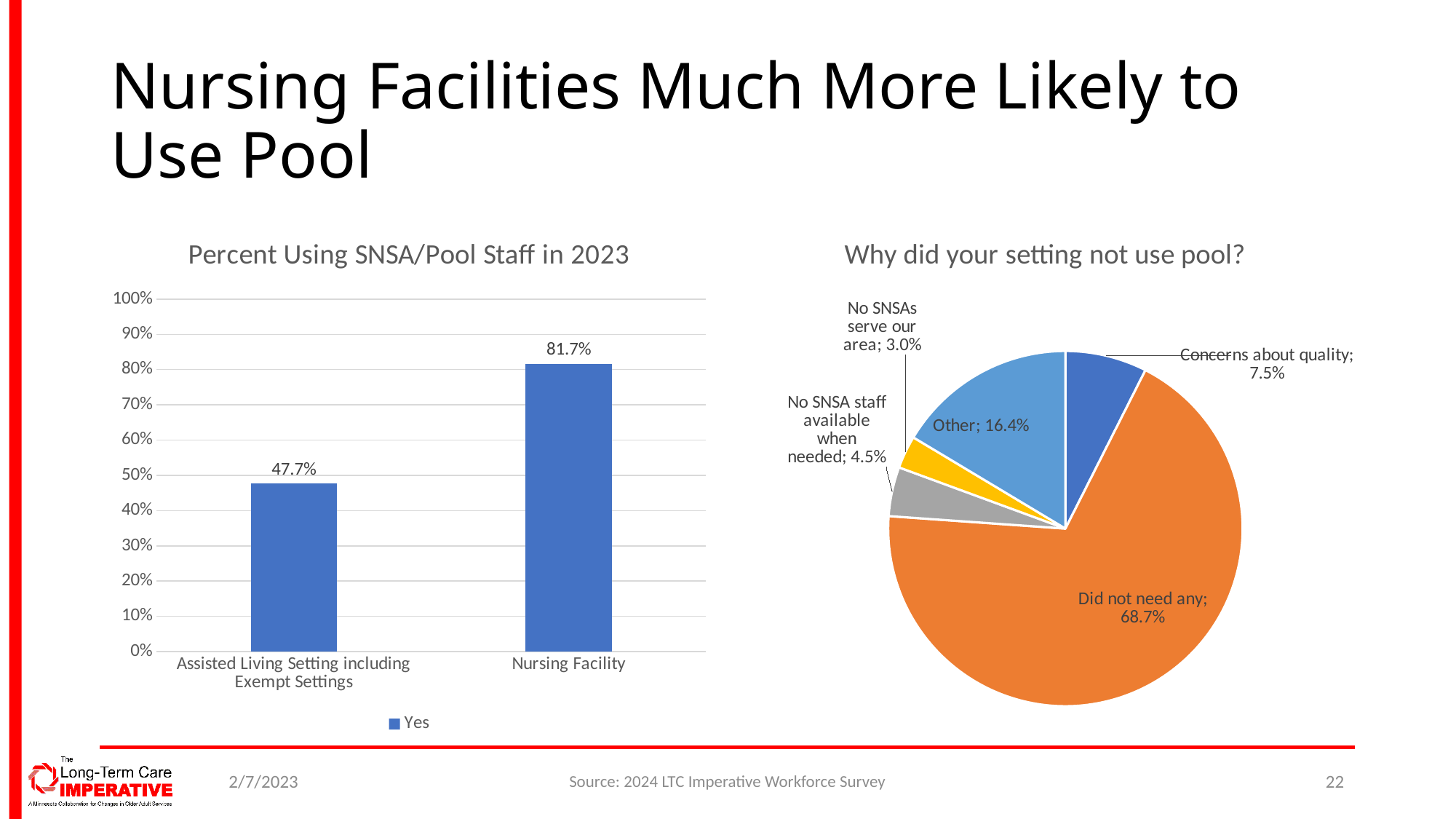
In the 'Why did your setting not use pool?' pie chart, which slice is the smallest? No SNSAs serve our area In the 'Percent Using SNSA/Pool Staff in 2023' chart, what is the difference between the Nursing Facility and Assisted Living values? 34.0% In the 'Percent Using SNSA/Pool Staff in 2023' chart, how many categories are shown on the x axis? 2 In the 'Percent Using SNSA/Pool Staff in 2023' chart, which category has the higher value? Nursing Facility In the 'Why did your setting not use pool?' pie chart, what share is 'Other'? 16.4% How many slices does the 'Why did your setting not use pool?' pie chart have? 5 In the 'Why did your setting not use pool?' pie chart, what share is 'Did not need any'? 68.7% In the 'Why did your setting not use pool?' pie chart, which is larger: 'Concerns about quality' or 'No SNSA staff available when needed'? Concerns about quality In the 'Percent Using SNSA/Pool Staff in 2023' chart, what is the value for Nursing Facility? 81.7% In the 'Percent Using SNSA/Pool Staff in 2023' chart, what series does the legend list? Yes In the 'Percent Using SNSA/Pool Staff in 2023' chart, what is the value for Assisted Living Setting including Exempt Settings? 47.7% What kind of chart is 'Percent Using SNSA/Pool Staff in 2023'? Bar chart